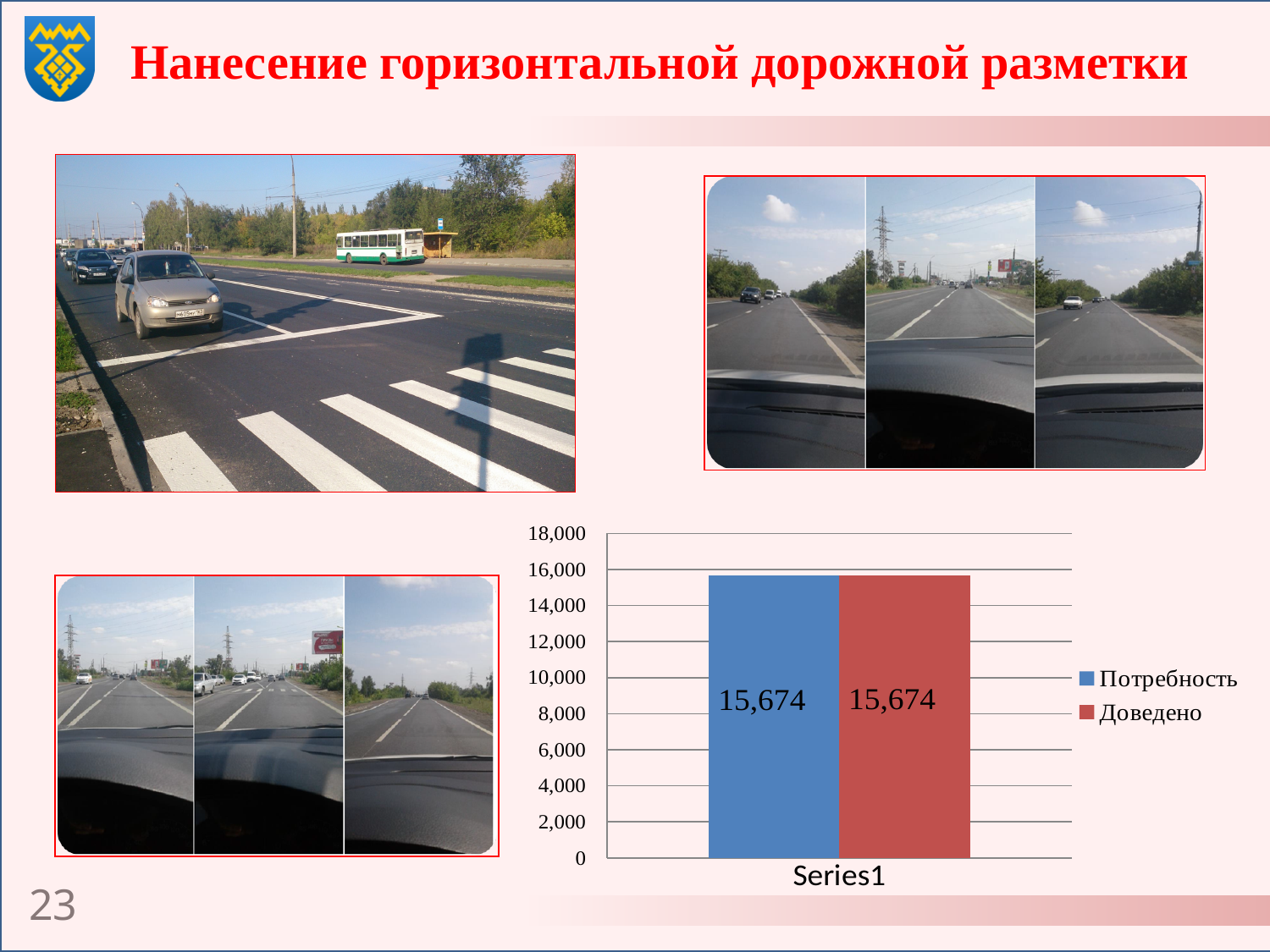
What is the value of Доведено in the bar chart? 15,674 How many series does the legend of the bar chart list? 2 What is the value of Потребность in the bar chart? 15,674 Is the value for Доведено greater or less than 16,000? less What is the category label on the x axis of the bar chart? Series1 What is the highest value shown on the y axis of the bar chart? 18,000 What kind of chart is shown on the slide? bar chart How many categories are shown on the x axis of the bar chart? 1 What colour is the Потребность bar in the chart? blue What is the difference between the Потребность and Доведено values in the bar chart? 0 Is the value for Потребность greater or less than 14,000? greater